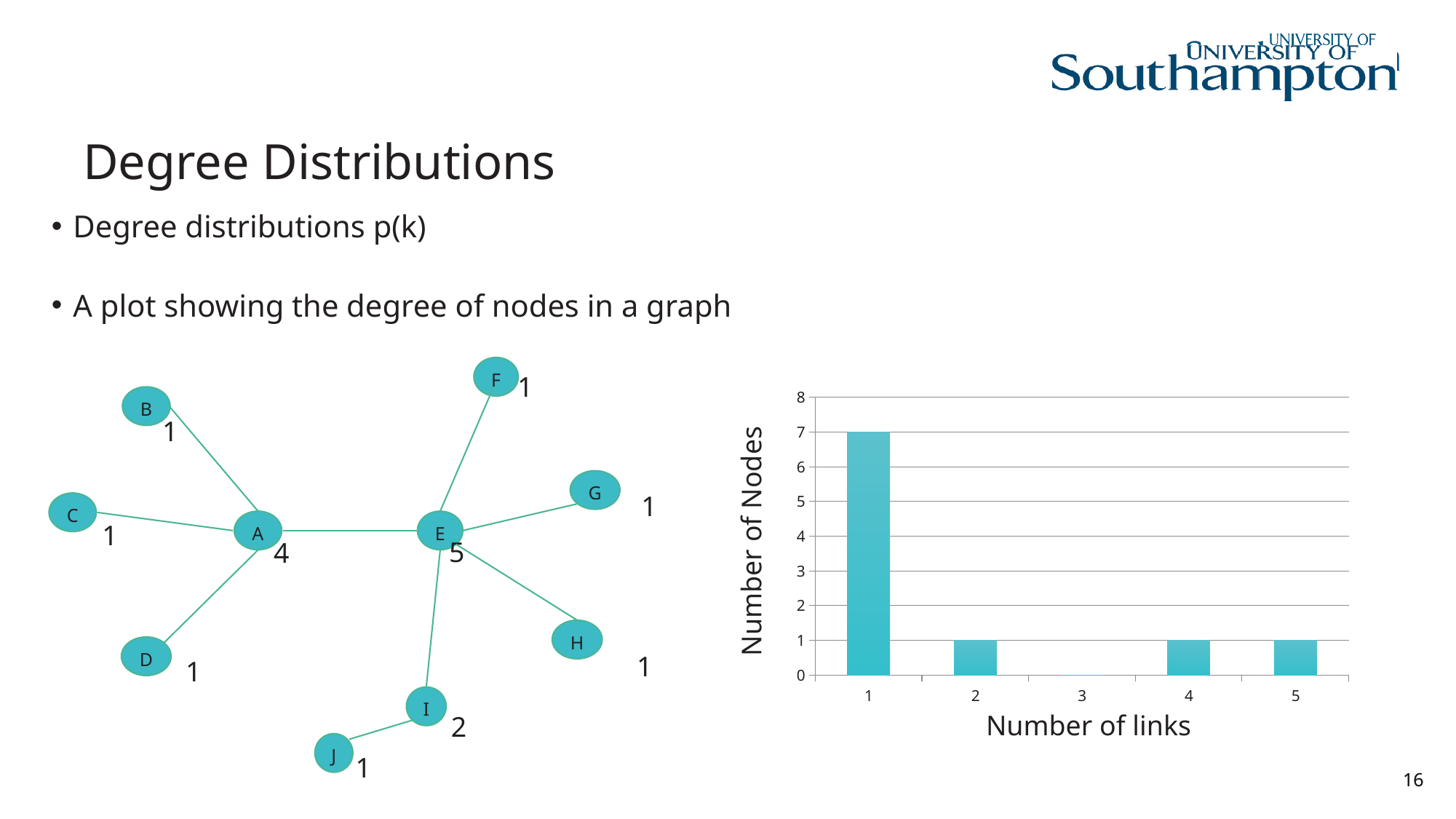
What is the label of the x axis of the bar chart? Number of links In the bar chart, is the number of nodes with 1 link greater or less than 6? greater In the bar chart, what is the difference between the number of nodes with 1 link and the number of nodes with 2 links? 6 What kind of chart is shown on the right of the slide? bar chart In the bar chart, how many nodes have 2 links? 1 In the bar chart, how many nodes have 4 links? 1 What is the label of the y axis of the bar chart? Number of Nodes In the bar chart, how many nodes have 5 links? 1 In the bar chart, which number of links has no bar at all? 3 In the bar chart, how many nodes have 1 link? 7 In the bar chart, which number of links has the highest number of nodes? 1 How many categories are shown on the x axis of the bar chart? 5